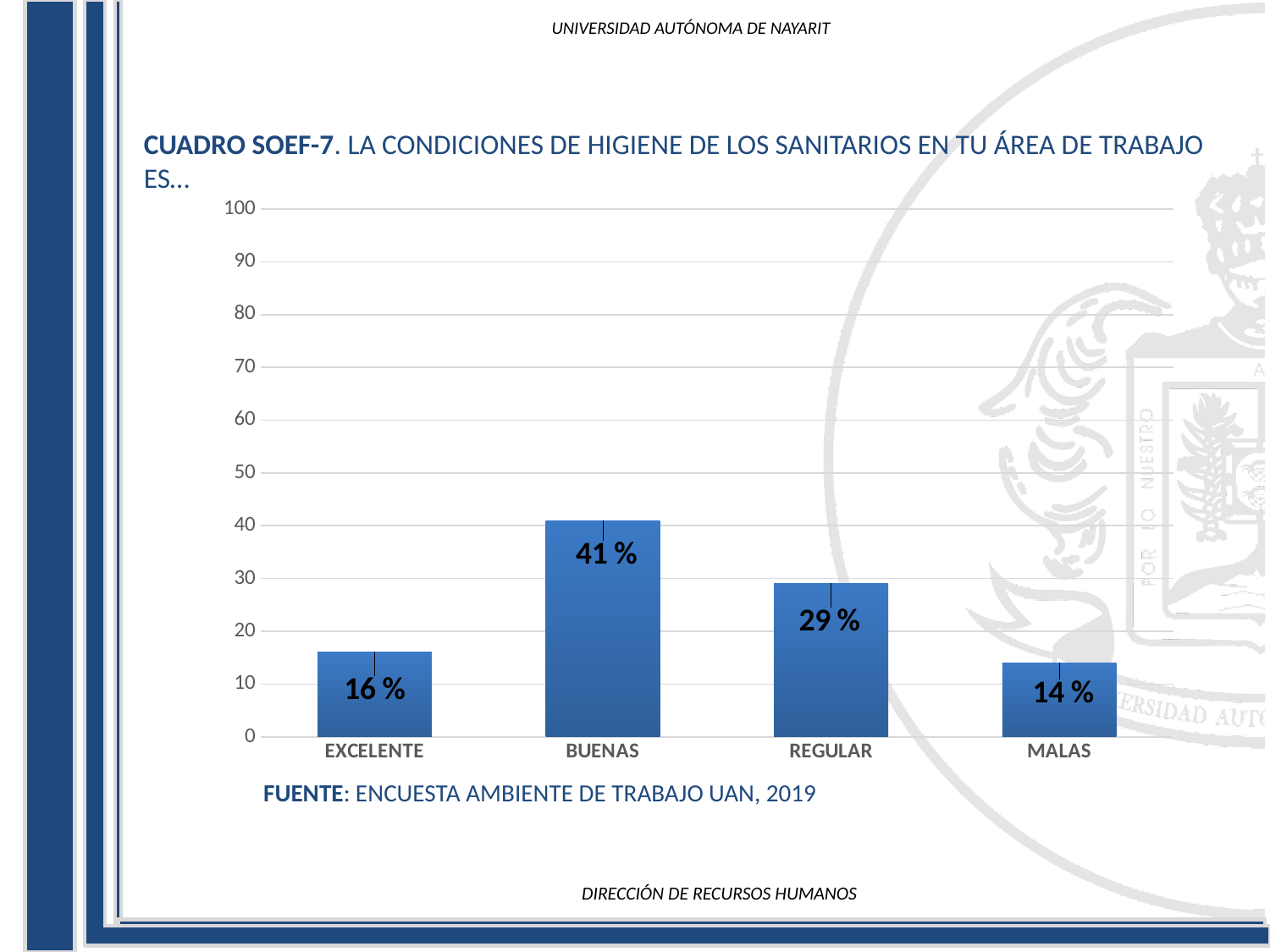
What is the difference between the values for BUENAS and REGULAR? 12 % Which category has the lowest value? MALAS What is the value for BUENAS? 41 % What is the highest value shown on the y axis? 100 What is the value for MALAS? 14 % What is the source cited below the chart? ENCUESTA AMBIENTE DE TRABAJO UAN, 2019 Is the value for REGULAR greater or less than 20? greater What kind of chart is shown on the slide? bar chart Which category has the highest value? BUENAS Which is larger, the value for EXCELENTE or the value for REGULAR? REGULAR How many categories are shown on the x axis? 4 What is the value for EXCELENTE? 16 %